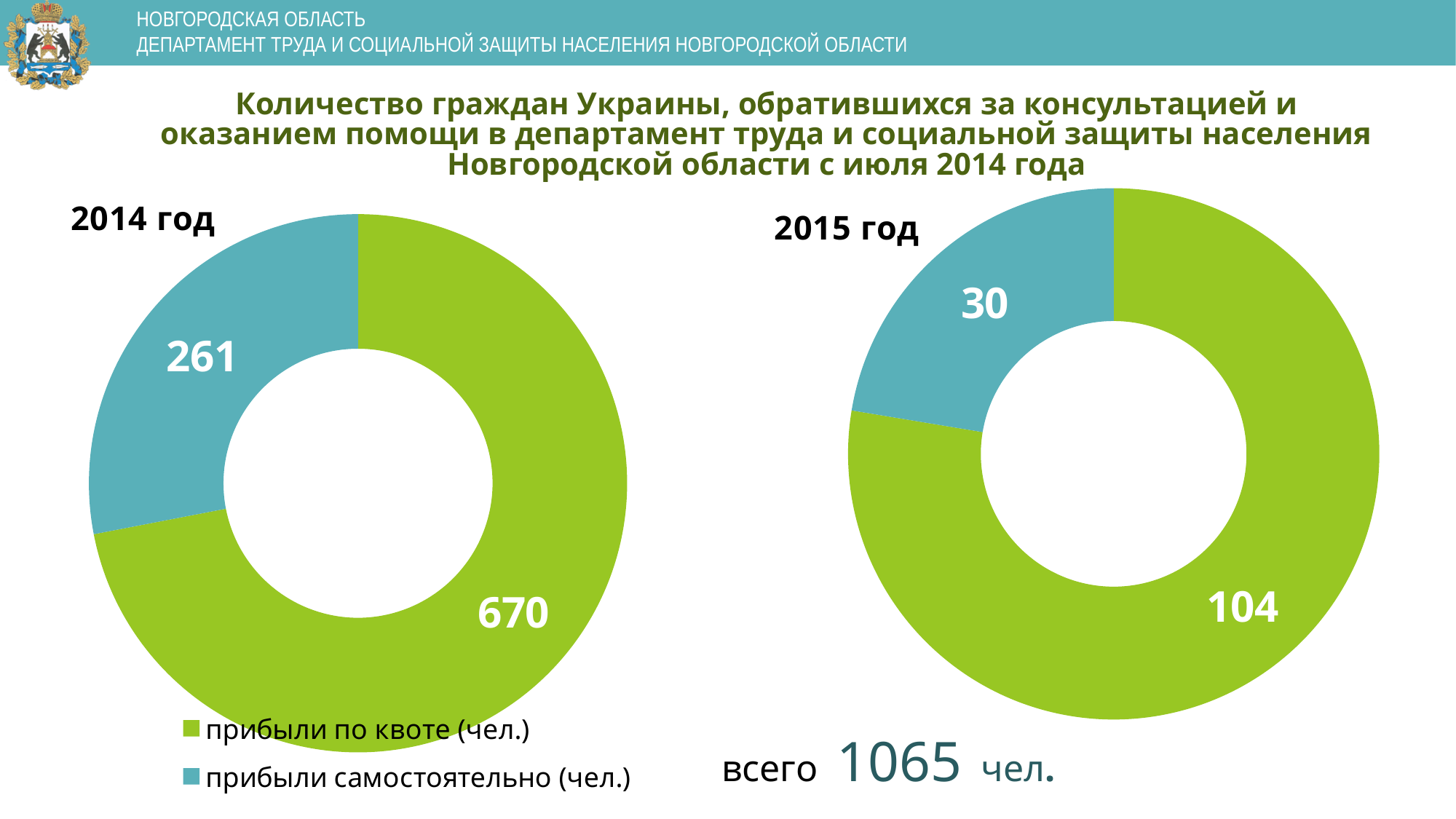
In the 2015 год chart, what is the difference between прибыли по квоте and прибыли самостоятельно? 74 How many categories does the legend list for the charts? 2 What type of chart is used for the 2014 год data? Donut (pie) chart In the 2014 год chart, which category has the largest slice? прибыли по квоте (чел.) In the 2015 год chart, which category has the smallest slice? прибыли самостоятельно (чел.) In the 2015 год chart, what is the value for прибыли самостоятельно (чел.)? 30 What is the total of the two values shown in the 2015 год chart? 134 In the 2014 год chart, what is the difference between прибыли по квоте and прибыли самостоятельно? 409 In the 2014 год chart, what is the value for прибыли самостоятельно (чел.)? 261 Which is larger: прибыли по квоте in the 2014 год chart or прибыли по квоте in the 2015 год chart? 2014 год In the 2014 год chart, what is the value for прибыли по квоте (чел.)? 670 In the 2015 год chart, what is the value for прибыли по квоте (чел.)? 104